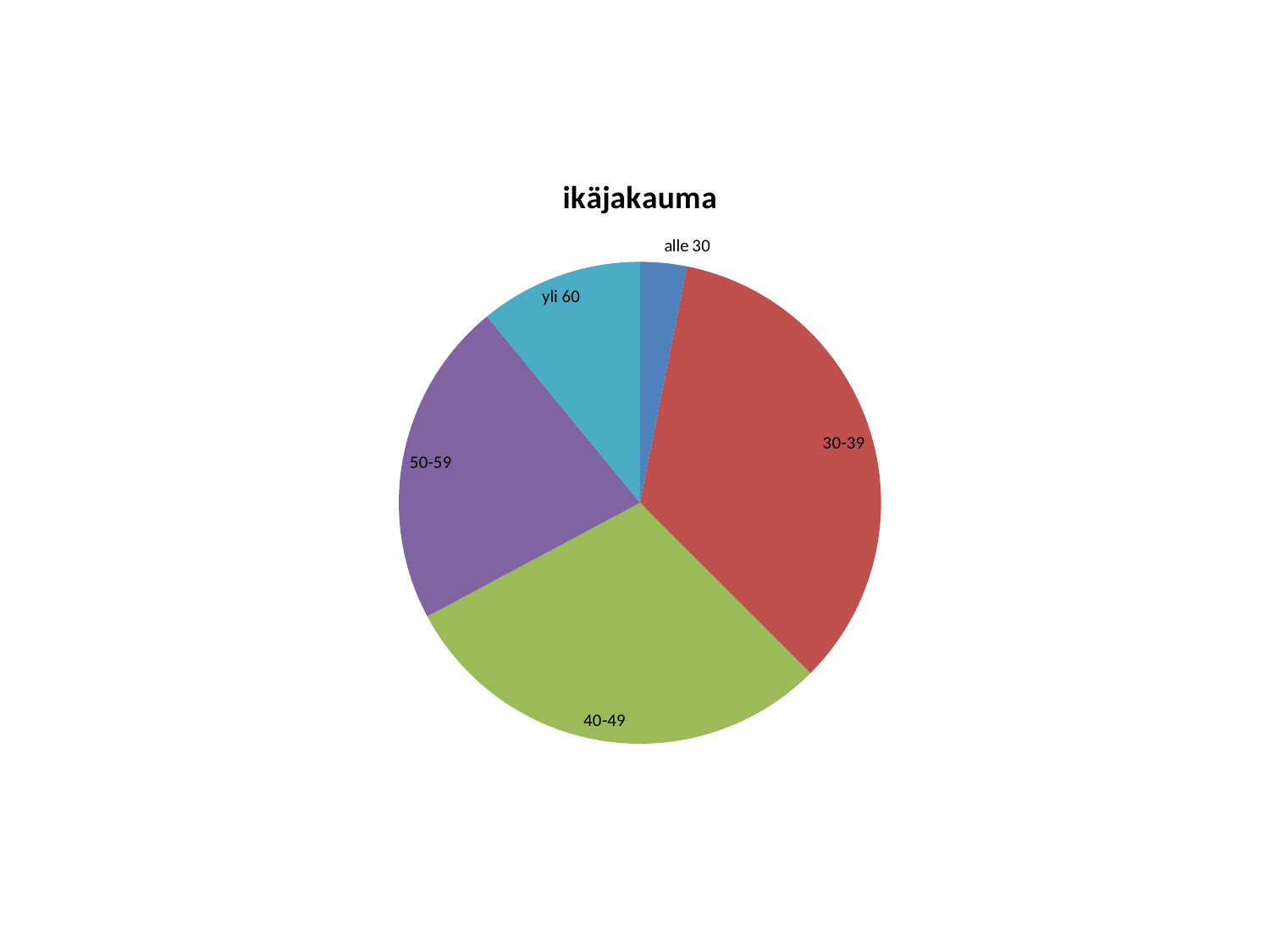
What colour is the 30-39 slice? red What is the title of the chart? ikäjakauma Which category has the smallest slice of the pie? alle 30 Which category has the largest slice of the pie? 30-39 How many slices does the pie chart have? 5 Which slice is larger, 40-49 or 50-59? 40-49 Which slice is larger, alle 30 or yli 60? yli 60 What kind of chart is shown on the slide? pie chart Which slice is larger, 50-59 or yli 60? 50-59